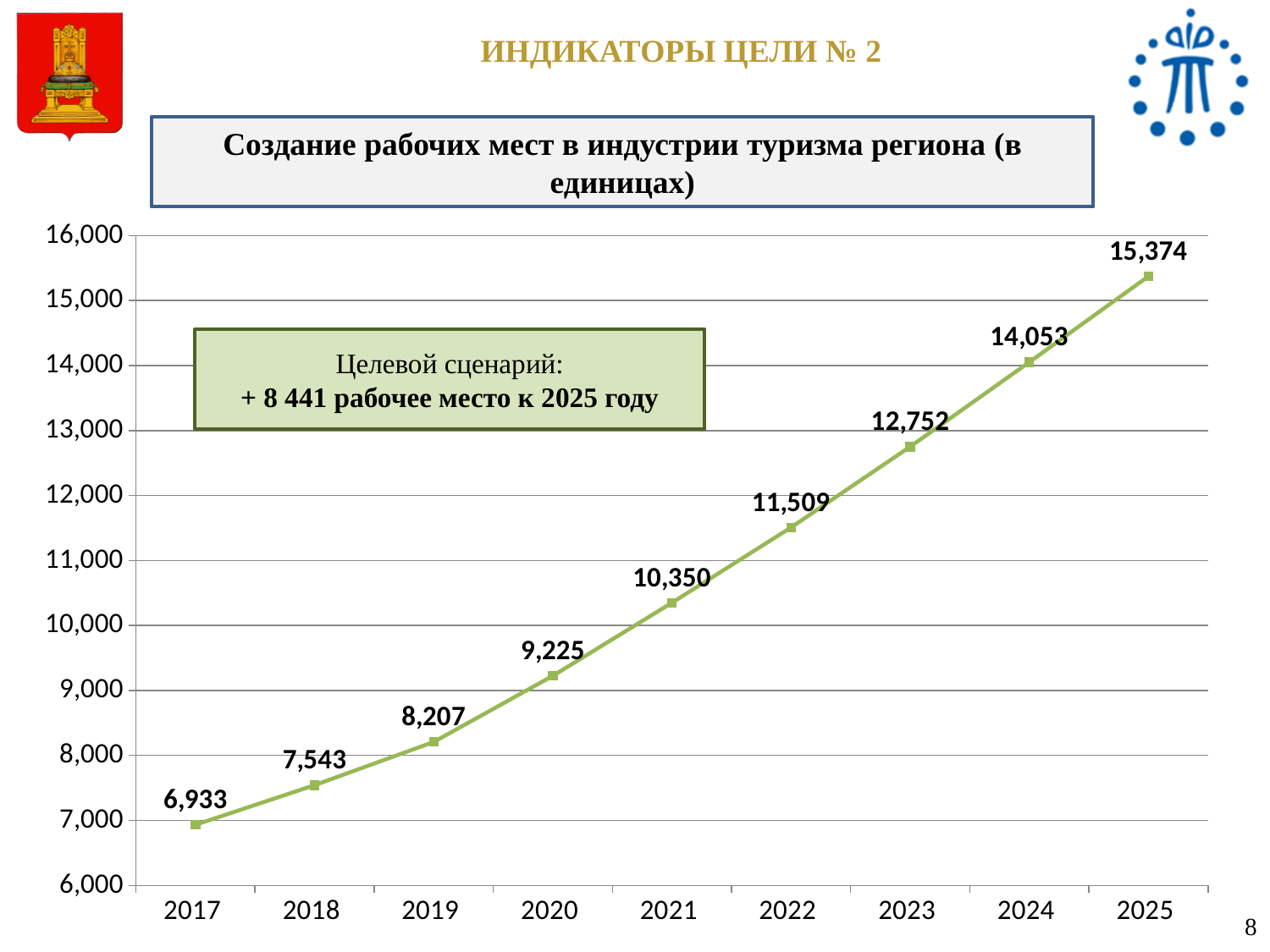
Which year has the highest value? 2025 What is the difference between the values for 2025 and 2017? 8,441 Which is larger, the value for 2022 or the value for 2023? 2023 What is the value for 2017? 6,933 What is the value for 2025? 15,374 Which year has the lowest value? 2017 Is the value for 2024 greater or less than 14,000? greater Do the values rise or fall from 2017 to 2025? rise What is the value for 2021? 10,350 What is the difference between the values for 2020 and 2019? 1,018 What kind of chart is shown on the slide? line chart How many years are plotted on the chart? 9